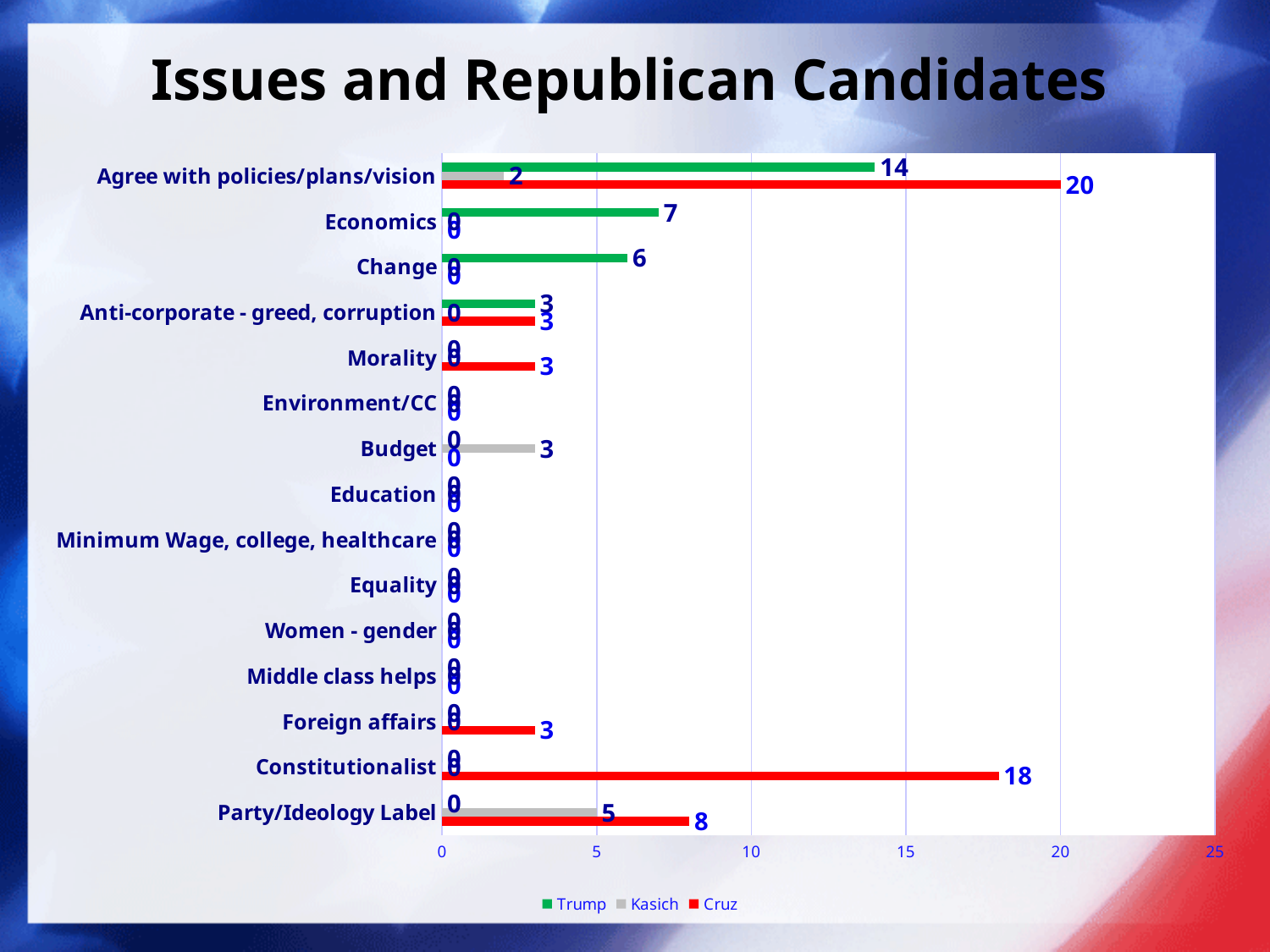
Which category has the highest value for Kasich? Party/Ideology Label What is the difference between Cruz and Trump on Agree with policies/plans/vision? 6 What is the value for Trump on Economics? 7 How many series does the legend list? 3 Which category has the highest value for Trump? Agree with policies/plans/vision What is the value for Cruz on Agree with policies/plans/vision? 20 What is the value for Cruz on Constitutionalist? 18 What is the title of the chart? Issues and Republican Candidates What kind of chart is shown on the slide? Bar chart What is the value for Kasich on Party/Ideology Label? 5 On Party/Ideology Label, which is larger, the value for Cruz or the value for Kasich? Cruz How many categories are shown on the chart? 15